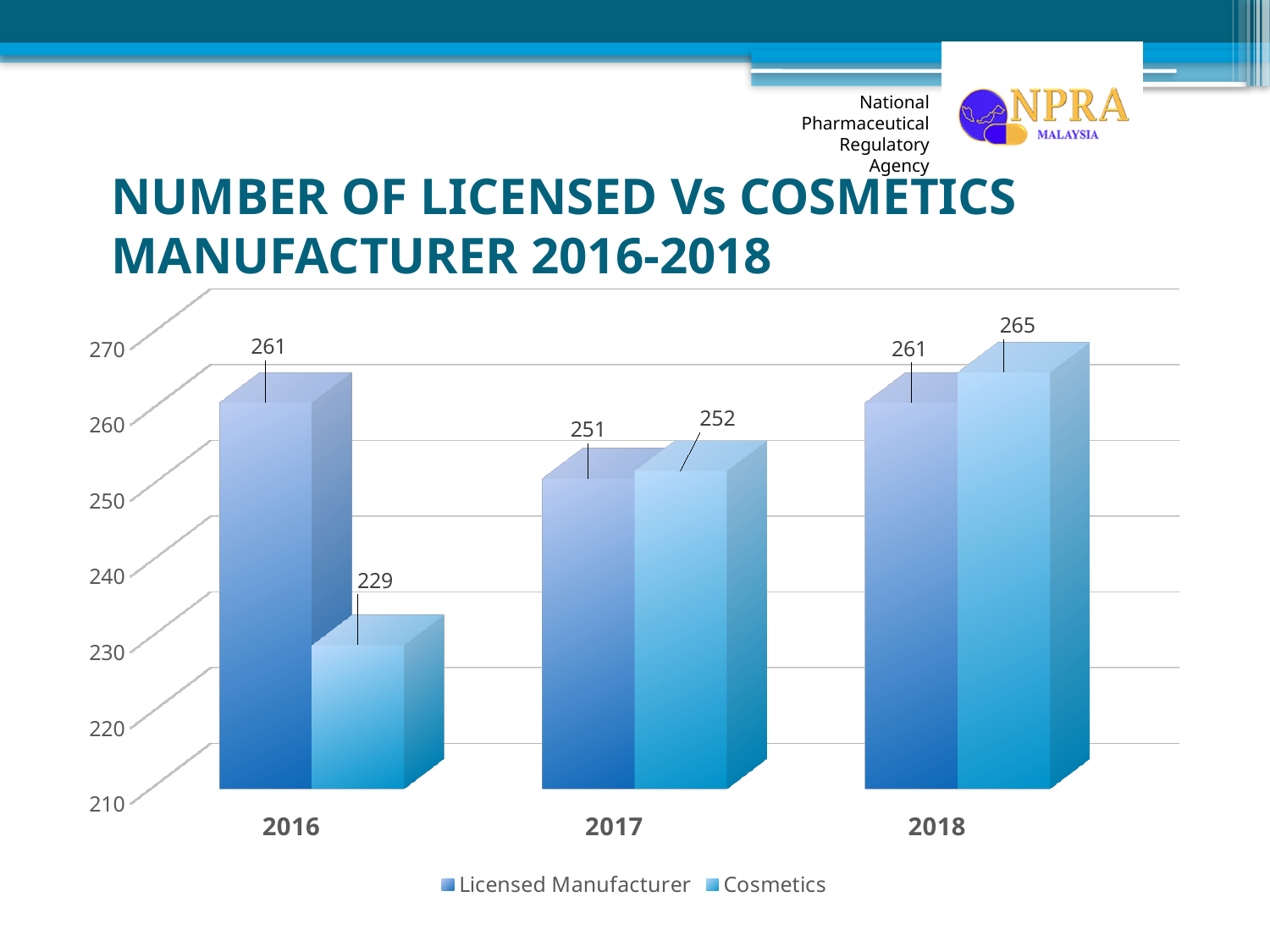
What is the value for Cosmetics in 2016? 229 How many years are shown on the x axis? 3 In which year is the Cosmetics value highest? 2018 Do the Cosmetics values rise or fall from 2016 to 2018? Rise What is the value for Licensed Manufacturer in 2016? 261 What is the value for Licensed Manufacturer in 2018? 261 What is the difference between the Licensed Manufacturer and Cosmetics values in 2016? 32 What is the value for Cosmetics in 2017? 252 In which year is the Licensed Manufacturer value lowest? 2017 Which is larger in 2018, Licensed Manufacturer or Cosmetics? Cosmetics What kind of chart is shown on the slide? Bar chart How many series does the legend list? 2